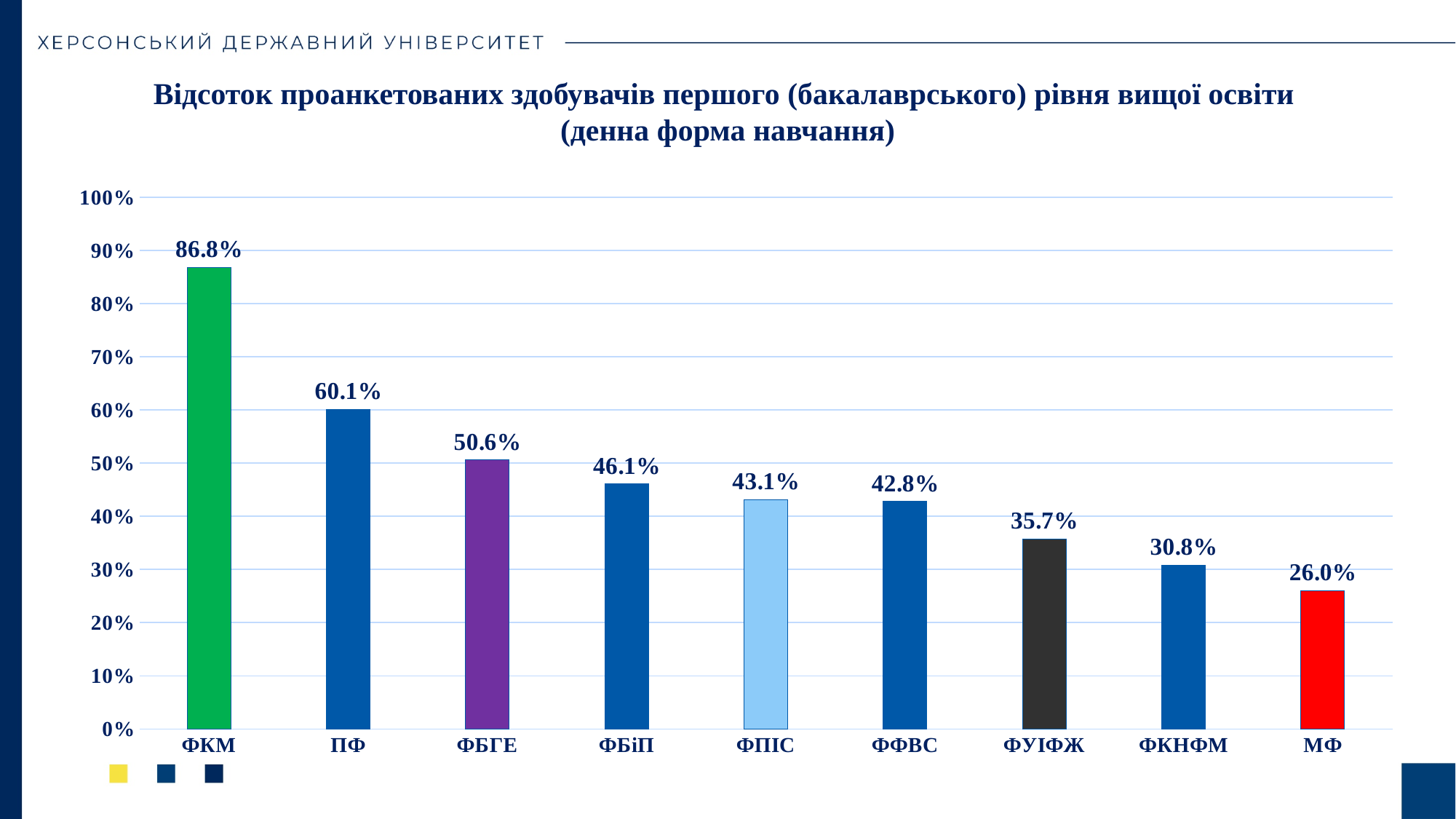
What colour is the bar for МФ? red Do the values rise or fall from left to right along the x axis? fall What is the value for ФКМ? 86.8% How many faculties (categories) are shown on the chart? 9 What is the difference between the values for ПФ and ФБГЕ? 9.5% Which faculty has the lowest percentage? МФ What type of chart is shown on the slide? bar chart What is the value for ФКНФМ? 30.8% What is the difference between the values for ФКМ and ПФ? 26.7% Which is larger, the value for ФБіП or the value for ФУІФЖ? ФБіП What is the value for ФПІС? 43.1% Which faculty has the highest percentage? ФКМ